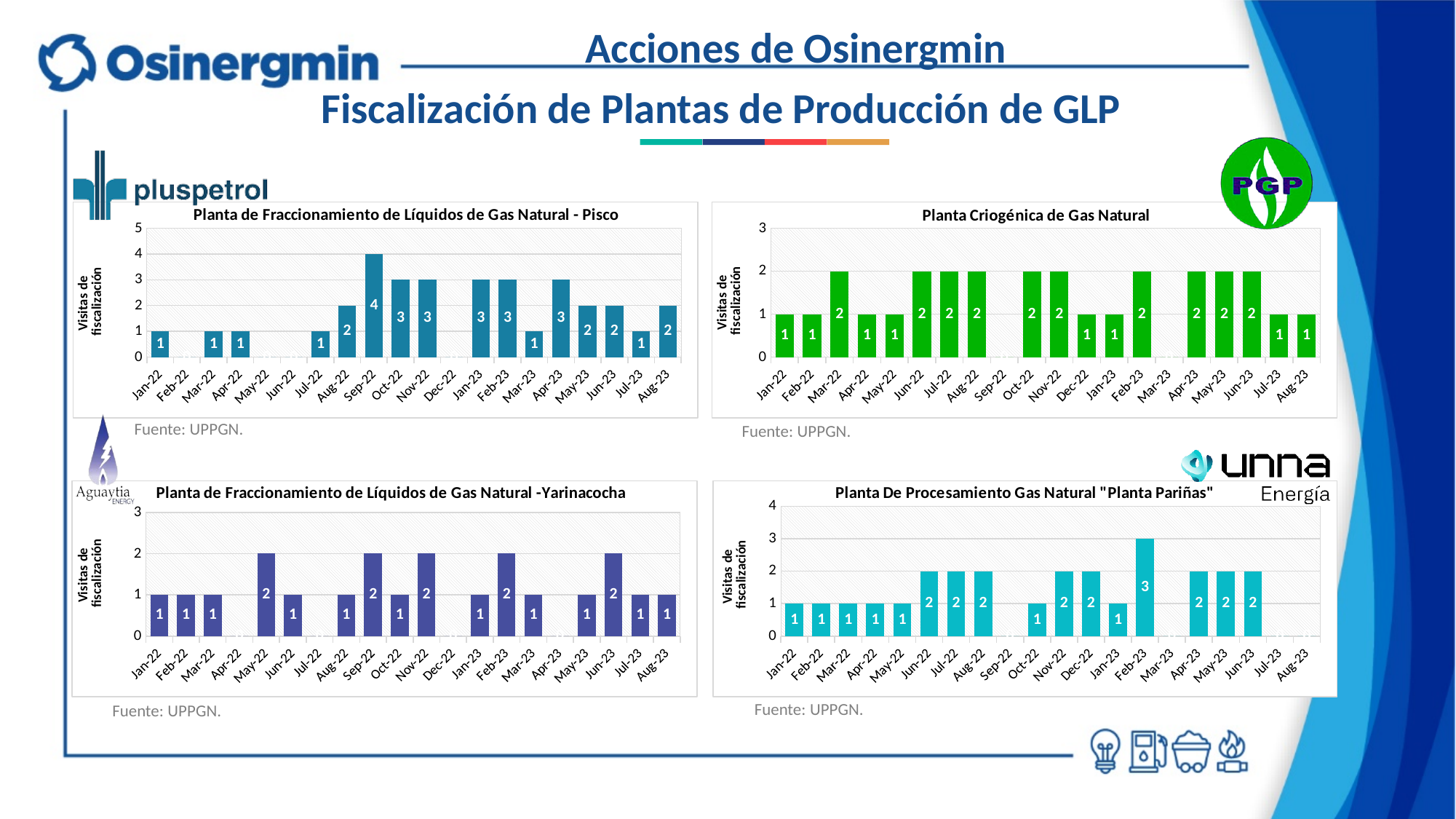
In the 'Planta de Fraccionamiento de Líquidos de Gas Natural - Pisco' chart, what is the difference between the visits in Sep-22 and Aug-22? 2 In the 'Planta De Procesamiento Gas Natural "Planta Pariñas"' chart, how many visits were there in Jun-22? 2 In the 'Planta de Fraccionamiento de Líquidos de Gas Natural -Yarinacocha' chart, what is the difference between the visits in Feb-23 and Mar-23? 1 In the 'Planta Criogénica de Gas Natural' chart, what is the maximum value shown on the vertical axis? 3 In the 'Planta Criogénica de Gas Natural' chart, which is larger, the value for Dec-22 or the value for Feb-23? Feb-23 In the 'Planta de Fraccionamiento de Líquidos de Gas Natural - Pisco' chart, how many visitas de fiscalización were there in Sep-22? 4 In the 'Planta Criogénica de Gas Natural' chart, how many visits were there in Mar-22? 2 What type of chart is the 'Planta De Procesamiento Gas Natural "Planta Pariñas"' chart? Bar chart How many charts are shown on the slide? 4 In the 'Planta De Procesamiento Gas Natural "Planta Pariñas"' chart, which month has the highest number of visits? Feb-23 In the 'Planta de Fraccionamiento de Líquidos de Gas Natural - Pisco' chart, which month has the highest number of visits? Sep-22 In the 'Planta de Fraccionamiento de Líquidos de Gas Natural -Yarinacocha' chart, how many visits were there in May-22? 2